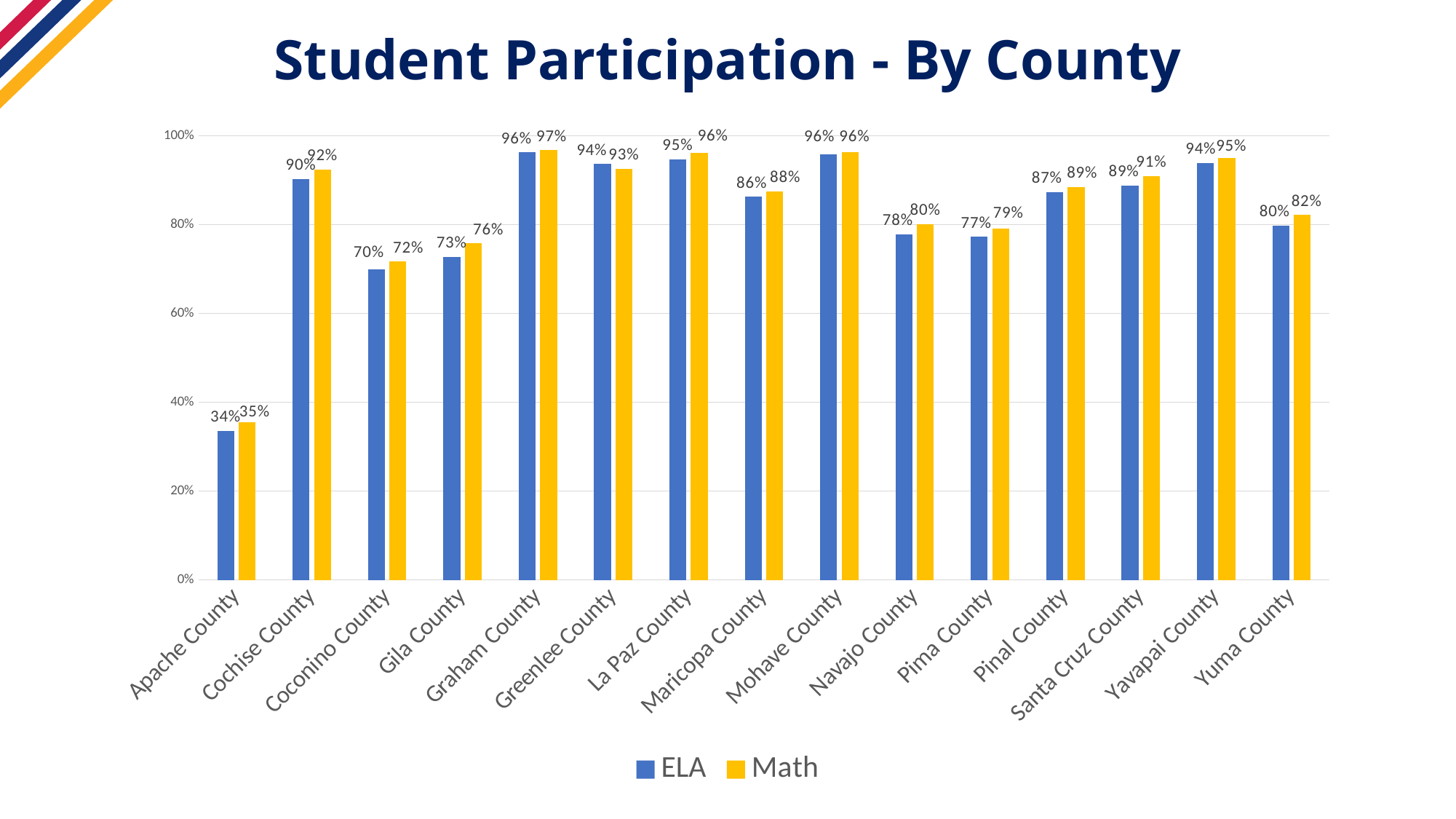
What is the ELA participation rate for Maricopa County? 86% How many counties are shown on the chart? 15 Is the ELA participation rate for Apache County greater or less than 40%? less What is the difference between the ELA participation rates of Cochise County and Coconino County? 20% What is the difference between the Math and ELA participation rates for Gila County? 3% How many series does the legend list? 2 What type of chart is shown on the slide? Bar chart What is the Math participation rate for Santa Cruz County? 91% Which is higher for Greenlee County, the ELA rate or the Math rate? ELA Which county has the lowest ELA participation rate? Apache County Which county has the highest Math participation rate? Graham County What is the Math participation rate for Gila County? 76%